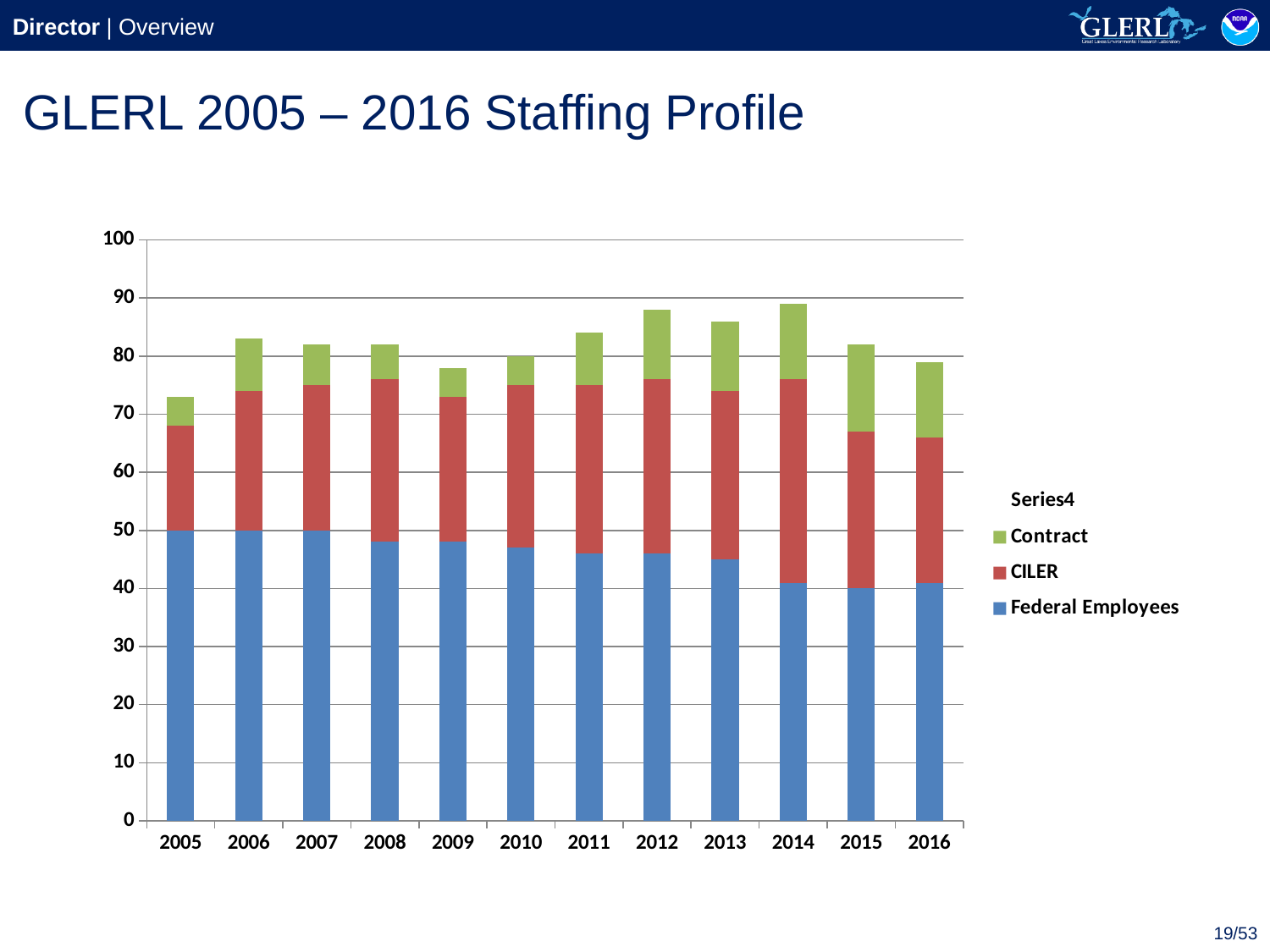
Which year has the lowest total staffing bar? 2005 How many years are shown along the x axis of the chart? 12 What is the value for Federal Employees in 2015? 40 Is the total staffing bar for 2014 greater or less than 80? greater Do the Federal Employees values generally rise or fall from 2005 to 2016? fall Which year has the larger Federal Employees value, 2005 or 2014? 2005 Is the total staffing bar for 2009 greater or less than 80? less Which year has the larger total staffing bar, 2005 or 2006? 2006 What is the value for Federal Employees in 2005? 50 Is the value for Federal Employees in 2016 greater or less than 50? less What kind of chart is shown on the slide? stacked bar chart Which legend entry has no colour marker next to it? Series4